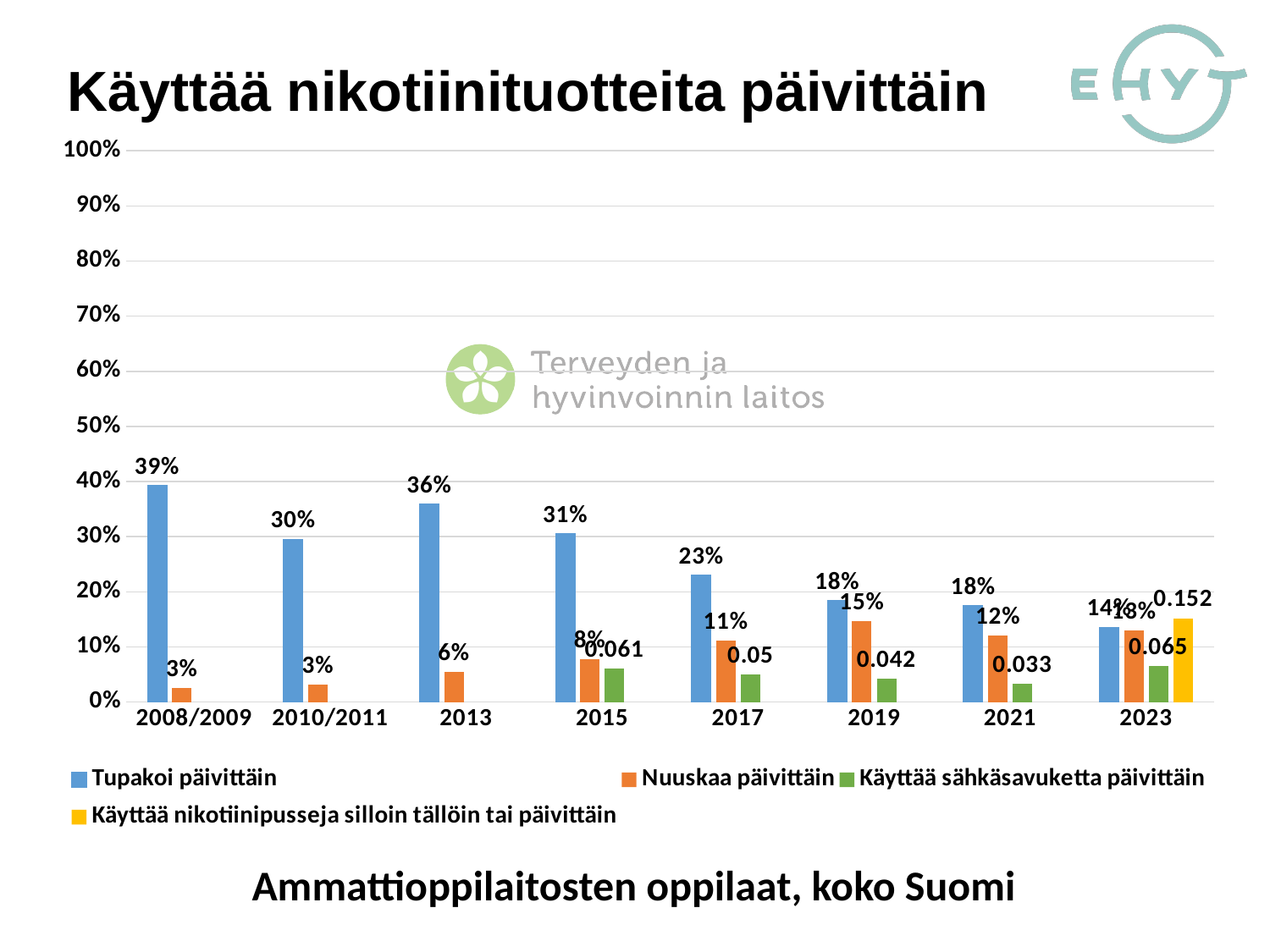
In which year is Nuuskaa päivittäin highest? 2019 What is the value for Käyttää sähkäsavuketta päivittäin in 2021? 0.033 What is the value for Käyttää nikotiinipusseja silloin tällöin tai päivittäin in 2023? 0.152 Does Tupakoi päivittäin generally rise or fall from 2008/2009 to 2023? fall What kind of chart is shown on the slide? bar chart What is the value for Nuuskaa päivittäin in 2017? 11% What is the value for Tupakoi päivittäin in 2008/2009? 39% In 2019, which is larger: Tupakoi päivittäin or Nuuskaa päivittäin? Tupakoi päivittäin How many year categories are shown on the x axis? 8 What is the difference between Tupakoi päivittäin in 2008/2009 and in 2015? 8 percentage points How many series does the legend list? 4 In which year is Tupakoi päivittäin highest? 2008/2009